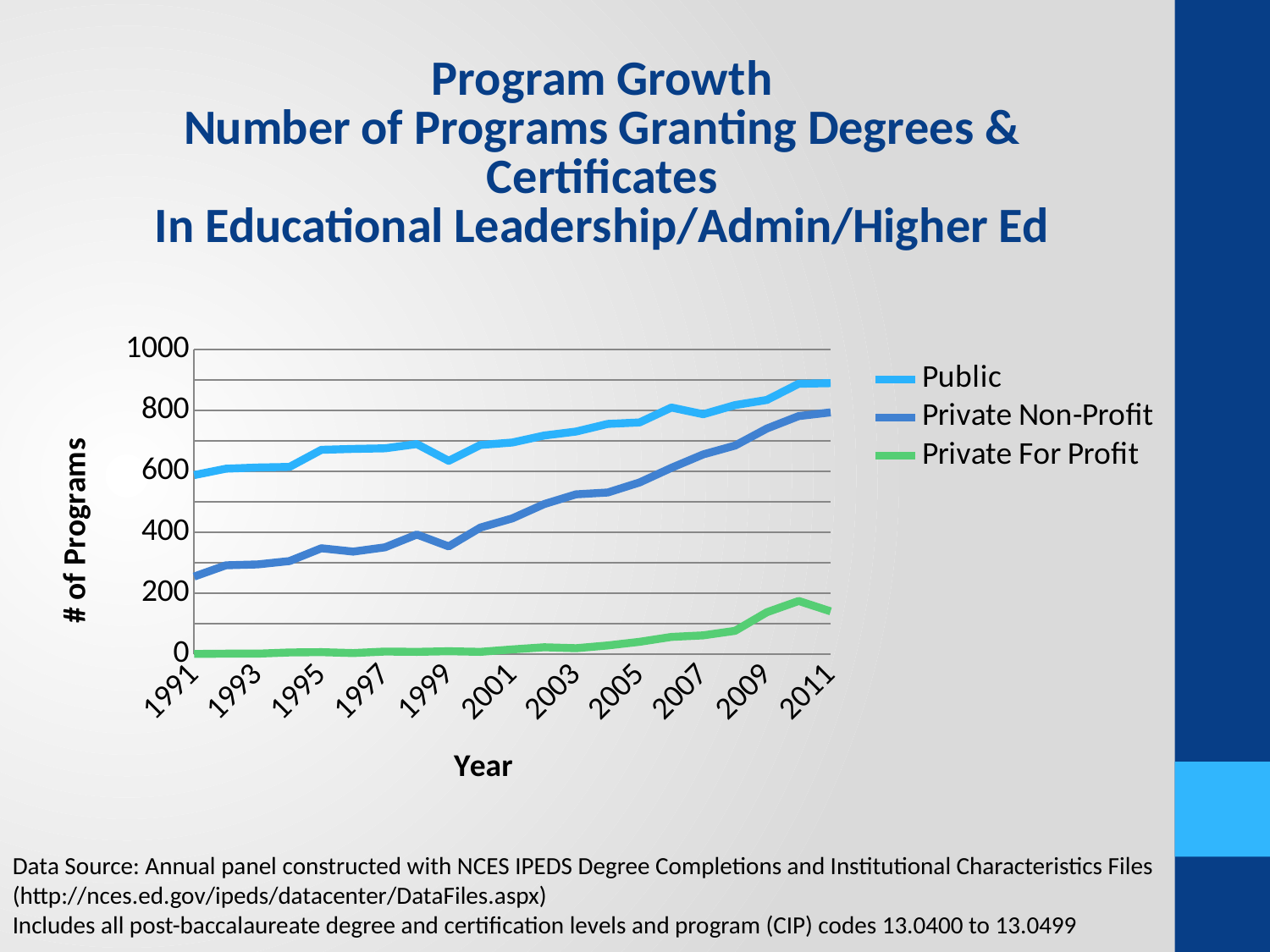
How many year labels are shown on the x axis? 11 In 1991, which is larger: Public or Private Non-Profit? Public Which series has the highest number of programs in 2011? Public Is the value for Private For Profit in 2011 greater or less than 200? less Is the value for Public in 2011 greater or less than 800? greater Do the values for Public generally rise or fall from 1991 to 2011? rise What is the title of the y axis? # of Programs Which series has the lowest number of programs in 2011? Private For Profit Is the value for Public in 1991 greater or less than 400? greater How many series does the legend list? 3 What kind of chart is shown on the slide? line chart